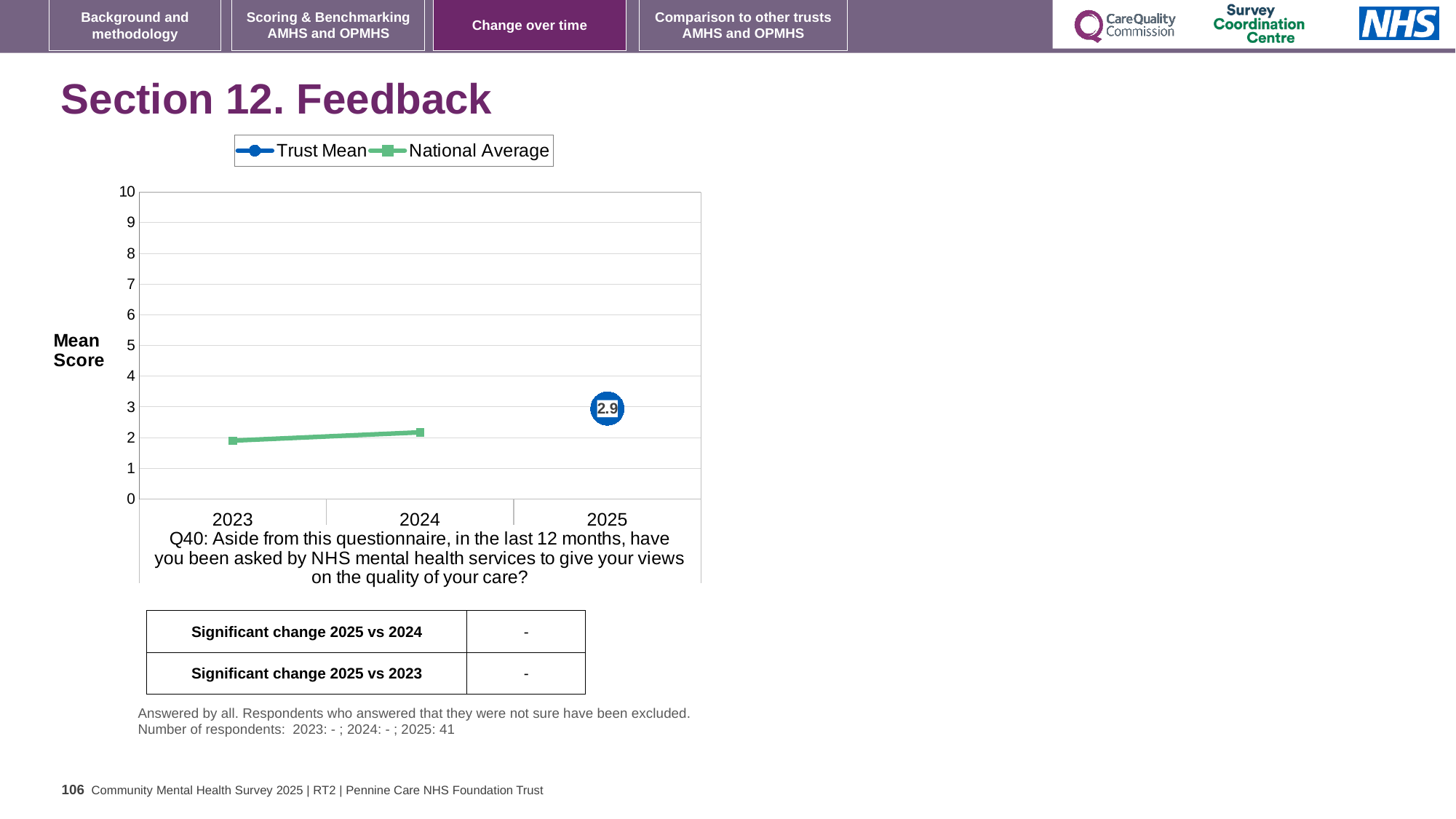
Which year has the higher National Average, 2023 or 2024? 2024 How many series does the legend list? 2 What kind of chart is shown on the slide? line chart Is the National Average value for 2024 greater or less than 1? greater Is the National Average value for 2023 greater or less than 3? less How many years are shown on the x axis? 3 Is the Trust Mean value for 2025 greater or less than 5? less What is the Trust Mean value for 2025? 2.9 What is the label on the vertical axis of the chart? Mean Score Does the National Average rise or fall from 2023 to 2024? rise Which is larger: the Trust Mean for 2025 or the National Average for 2024? Trust Mean for 2025 What are the two series named in the legend? Trust Mean and National Average